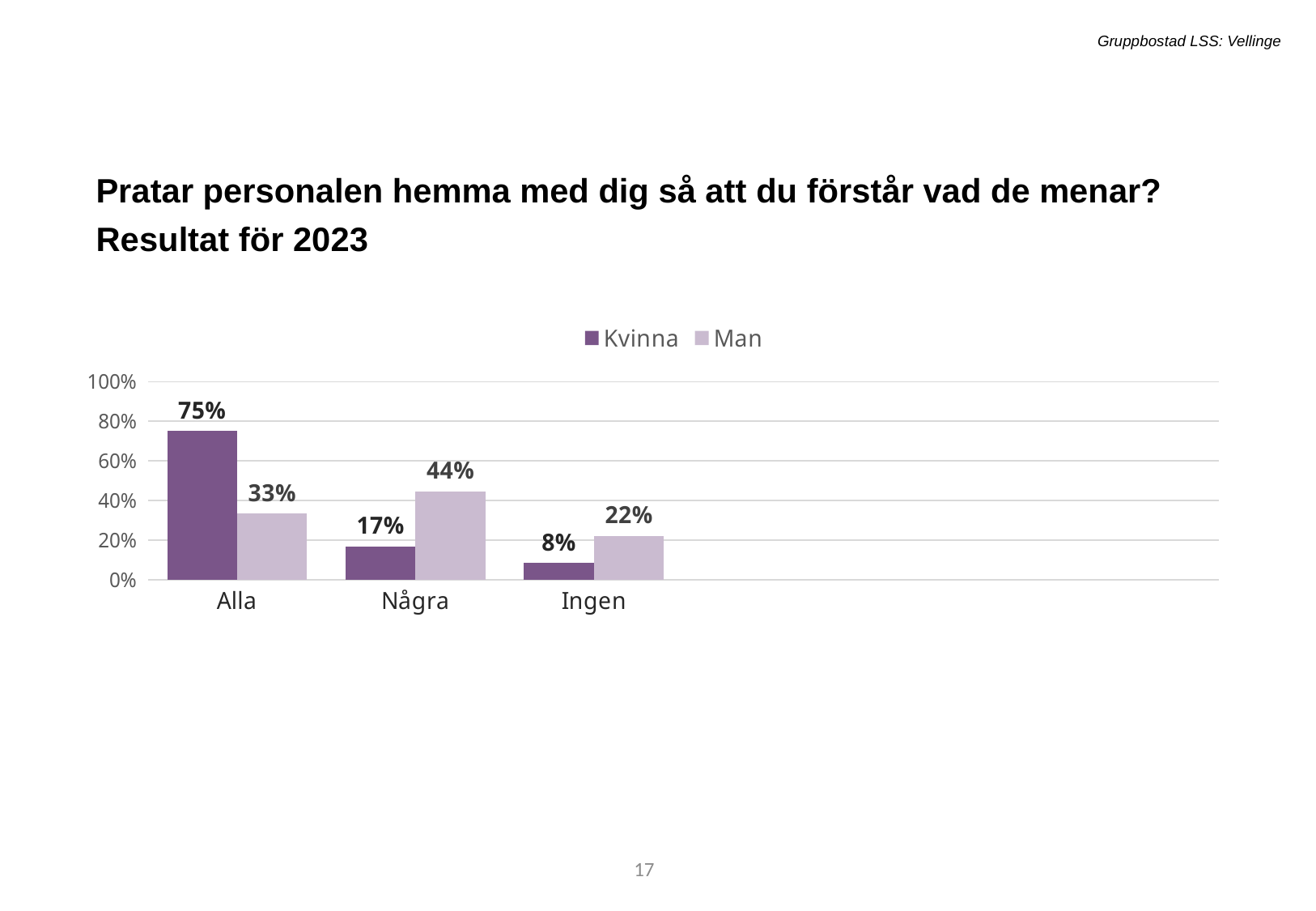
Which is larger in the Några category, Kvinna or Man? Man What is the difference between the Kvinna and Man values in the Alla category? 42% What is the value for Kvinna in the Ingen category? 8% What is the value for Man in the Alla category? 33% Which series is shown in the darker purple colour? Kvinna What is the value for Man in the Några category? 44% What kind of chart is shown on the slide? Bar chart Which category has the lowest value for Man? Ingen How many categories are shown on the x axis? 3 How many series does the legend list? 2 What is the value for Kvinna in the Alla category? 75% Which category has the highest value for Kvinna? Alla